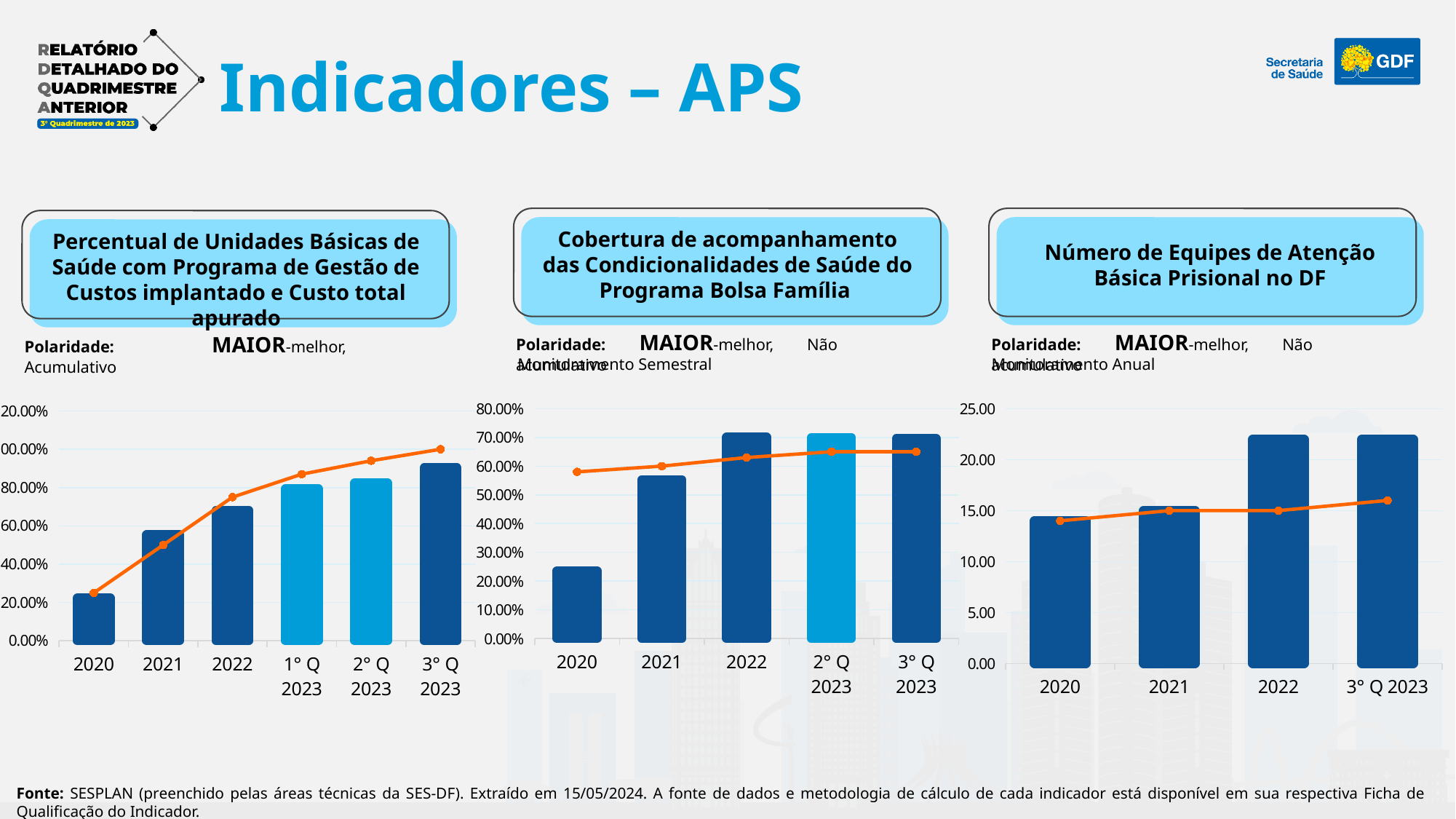
In the chart titled 'Cobertura de acompanhamento das Condicionalidades de Saúde do Programa Bolsa Família', how many categories are shown on the x axis? 5 In the chart titled 'Número de Equipes de Atenção Básica Prisional no DF', how many categories are shown on the x axis? 4 In the chart titled 'Cobertura de acompanhamento das Condicionalidades de Saúde do Programa Bolsa Família', is the bar for 2020 greater or less than 40.00%? less In the chart titled 'Percentual de Unidades Básicas de Saúde com Programa de Gestão de Custos implantado e Custo total apurado', which category has the shortest bar? 2020 In the chart titled 'Percentual de Unidades Básicas de Saúde com Programa de Gestão de Custos implantado e Custo total apurado', do the bar values rise or fall from 2020 to 3° Q 2023? rise In the chart titled 'Cobertura de acompanhamento das Condicionalidades de Saúde do Programa Bolsa Família', which bar is taller, 2021 or 2022? 2022 In the chart titled 'Cobertura de acompanhamento das Condicionalidades de Saúde do Programa Bolsa Família', which category has the shortest bar? 2020 In the chart titled 'Número de Equipes de Atenção Básica Prisional no DF', is the bar for 2022 greater or less than 20.00? greater In the chart titled 'Percentual de Unidades Básicas de Saúde com Programa de Gestão de Custos implantado e Custo total apurado', which category has the tallest bar? 3° Q 2023 In the chart titled 'Percentual de Unidades Básicas de Saúde com Programa de Gestão de Custos implantado e Custo total apurado', is the bar for 2021 greater or less than 40.00%? greater In the chart titled 'Número de Equipes de Atenção Básica Prisional no DF', which category has the shortest bar? 2020 In the chart titled 'Percentual de Unidades Básicas de Saúde com Programa de Gestão de Custos implantado e Custo total apurado', how many categories are shown on the x axis? 6